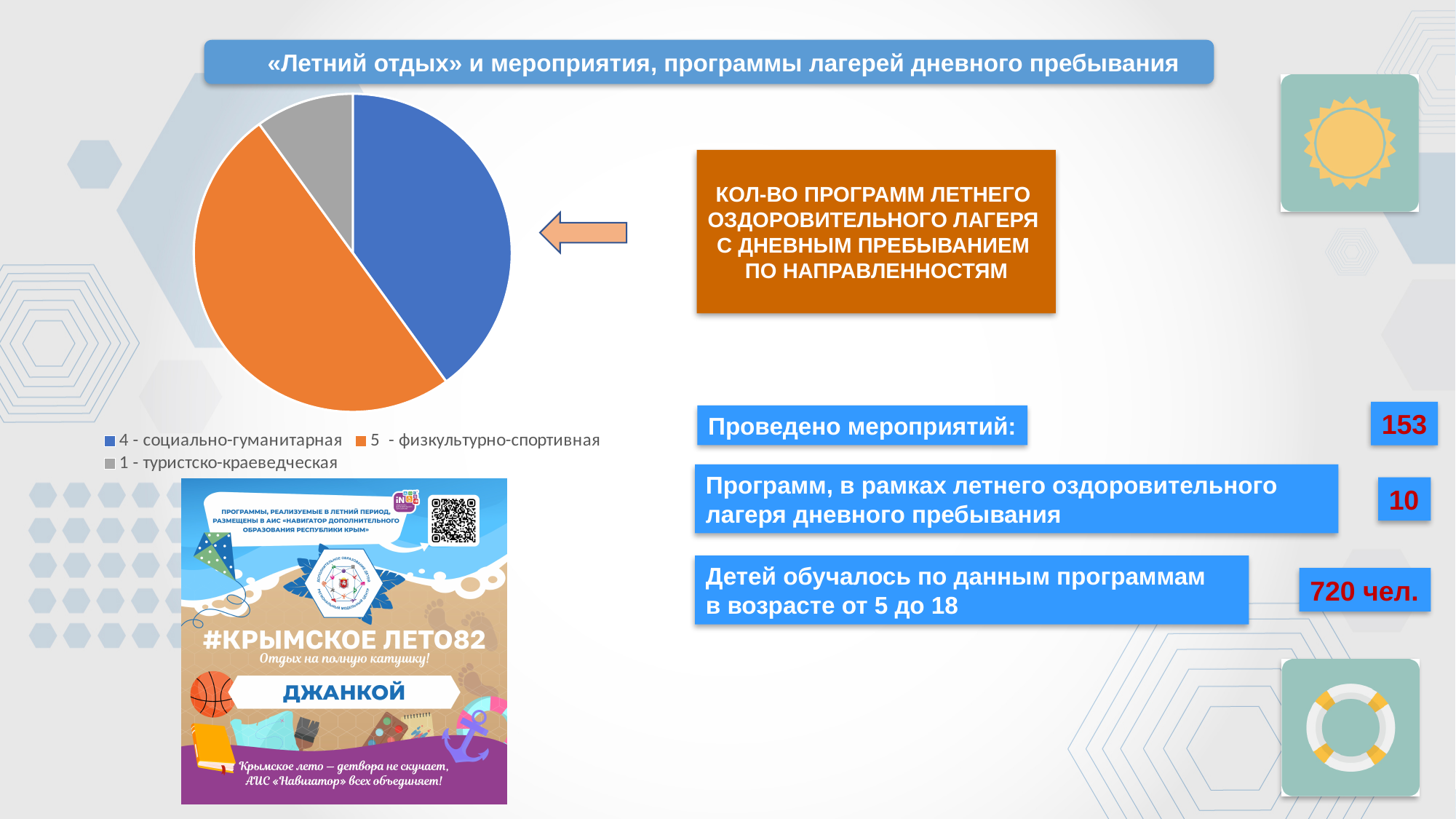
How many slices does the pie chart have? 3 Which category has the smallest slice of the pie chart? туристско-краеведческая Which category has the largest slice of the pie chart? физкультурно-спортивная How many entries does the legend of the pie chart list? 3 What is the difference between the number of физкультурно-спортивная programs and социально-гуманитарная programs? 1 According to the legend, how many programs are in the физкультурно-спортивная category? 5 Which is larger: the социально-гуманитарная slice or the туристско-краеведческая slice? социально-гуманитарная According to the legend, how many programs are in the социально-гуманитарная category? 4 What colour is the социально-гуманитарная slice in the pie chart? blue According to the legend, how many programs are in the туристско-краеведческая category? 1 What kind of chart is shown on the slide? pie chart What share of the pie does the физкультурно-спортивная slice represent? 50%